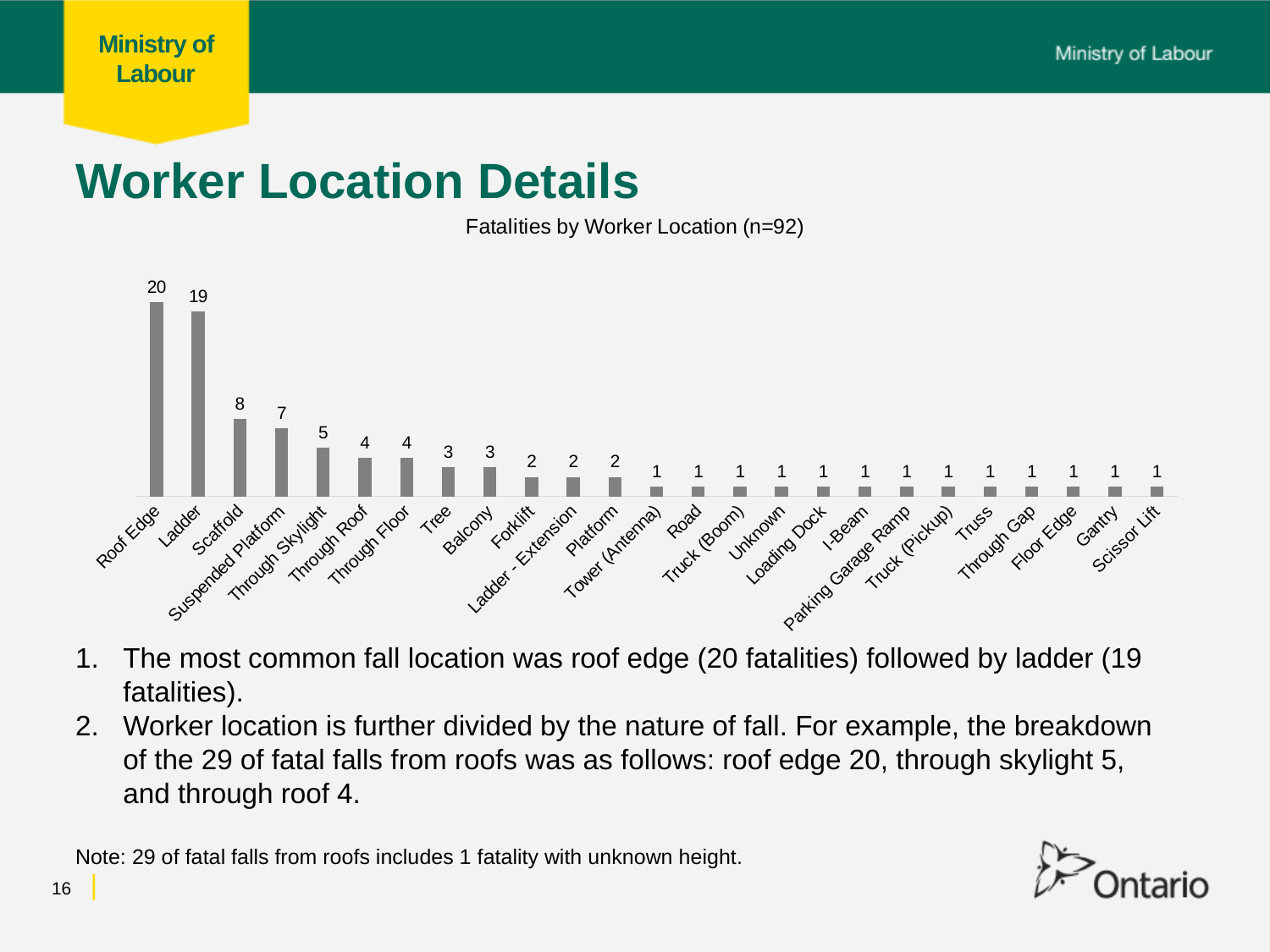
Which is larger, the value for Tree or the value for Forklift? Tree What is the title of the chart on the slide? Fatalities by Worker Location (n=92) What is the difference between the values for Roof Edge and Ladder? 1 What kind of chart is used to show Fatalities by Worker Location? Bar chart What is the value for Roof Edge in the Fatalities by Worker Location chart? 20 What is the value for Through Skylight? 5 How many fatalities are shown for Scaffold? 8 How many worker location categories are shown in the chart? 25 What is the difference between the values for Scaffold and Through Roof? 4 What is the value for Suspended Platform? 7 Which is larger, the value for Ladder or the value for Scaffold? Ladder Which worker location has the highest number of fatalities? Roof Edge